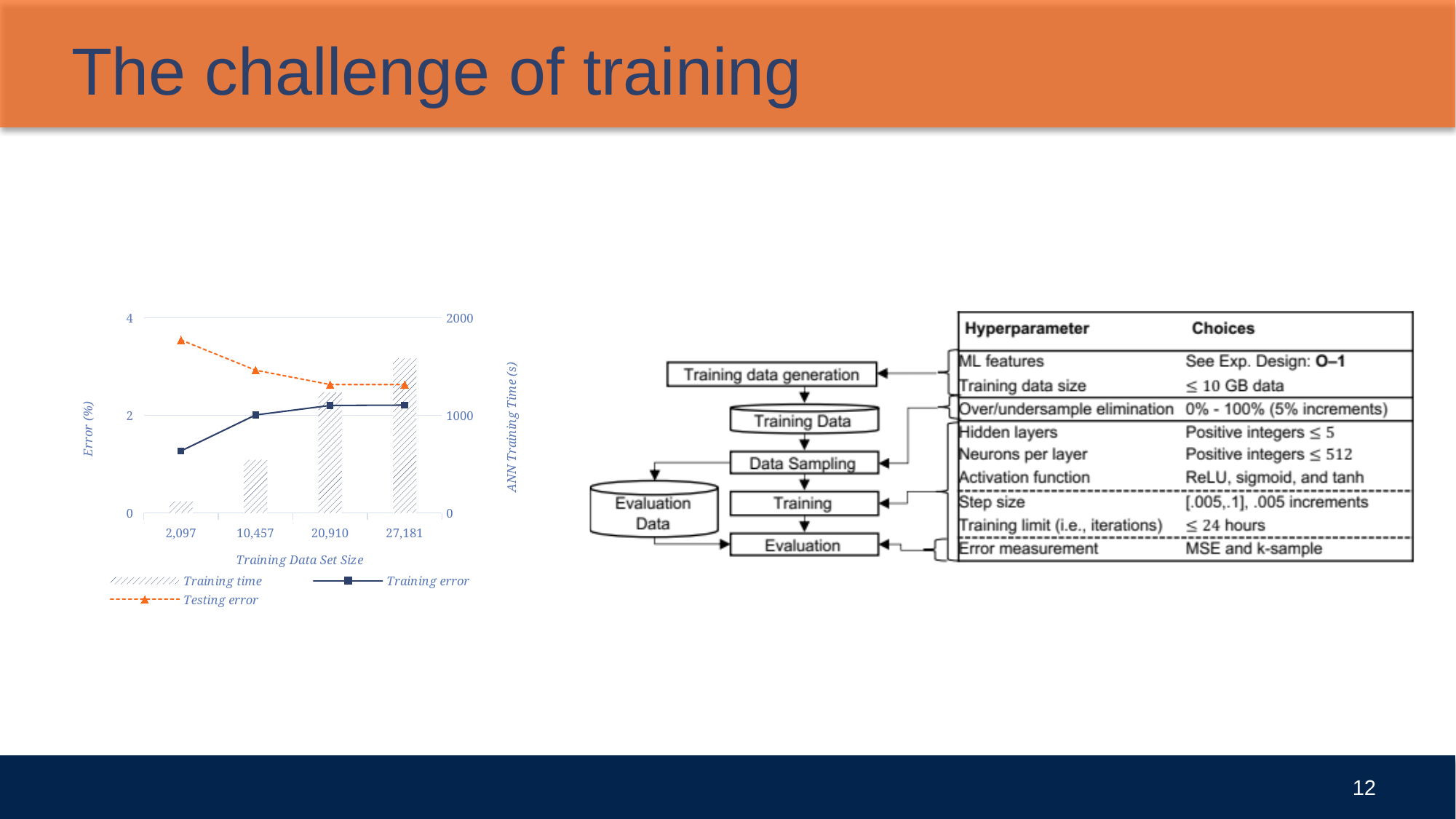
What is the title of the chart's x axis? Training Data Set Size Which training data set size has the lowest Training time? 2,097 What kind of chart is shown on the left of the slide? bar and line chart How many training data set sizes are shown on the x axis of the chart? 4 Is the Training time for 27,181 greater or less than 1000? greater Does the Training time rise or fall as the training data set size increases? rises How many series does the chart's legend list? 3 Is the Testing error for 2,097 greater or less than 2? greater Which training data set size has the highest Training time? 27,181 Is the Training time for 10,457 greater or less than 1000? less At a training data set size of 2,097, which is larger, the Testing error or the Training error? Testing error Does the Testing error rise or fall as the training data set size increases? falls